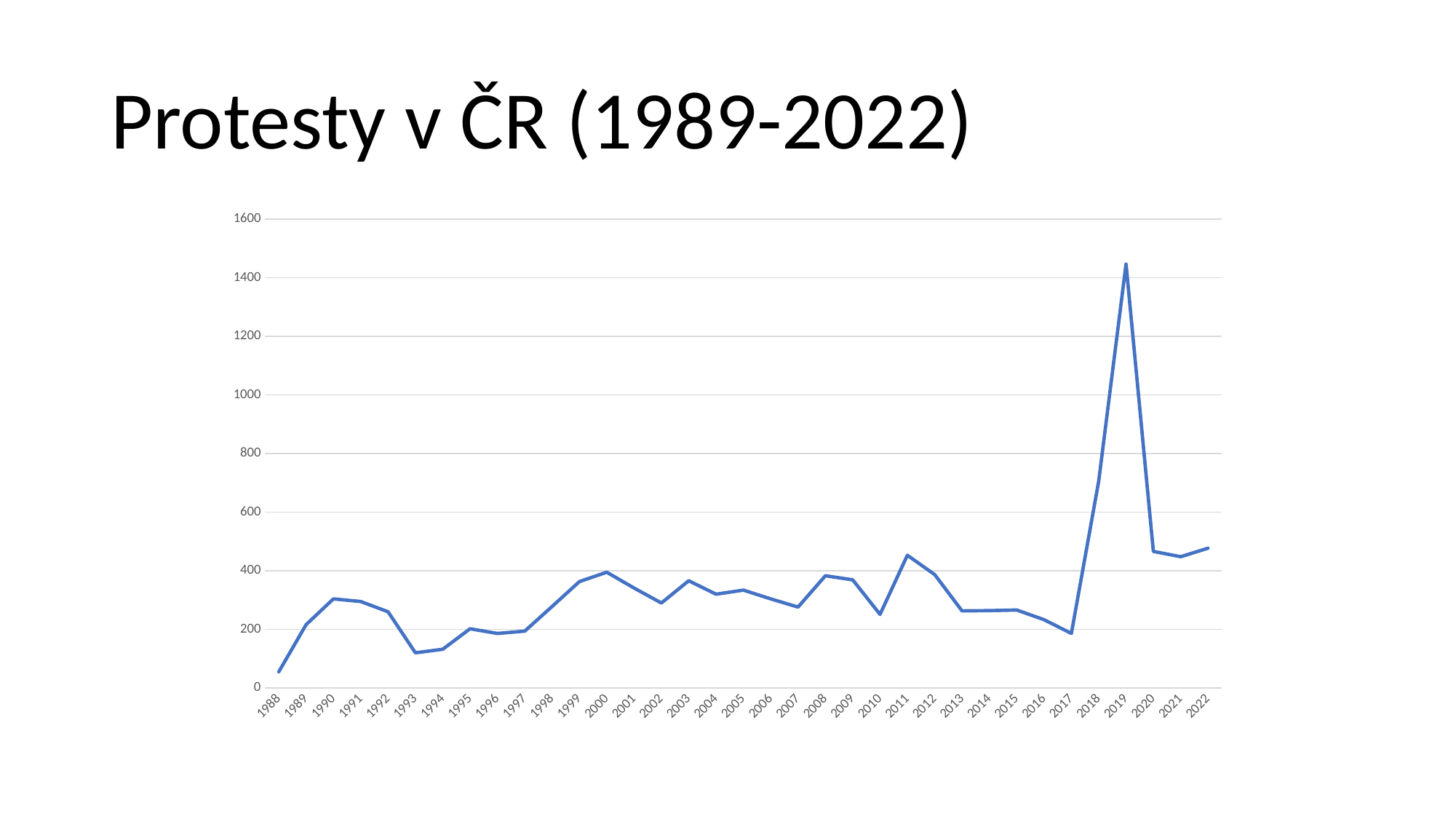
Which year has the lowest value on the chart? 1988 How many years are plotted along the x axis? 35 What kind of chart is shown on the slide? line chart Which year has the highest value on the chart? 2019 Is the value for 2011 greater or less than 400? greater Is the value for 1988 greater or less than 100? less What is the title of the slide? Protesty v ČR (1989-2022) Is the value for 2019 greater or less than 1200? greater Which year has the larger value, 1990 or 1993? 1990 Do the values rise or fall from 2019 to 2020? fall Which year has the larger value, 2019 or 2020? 2019